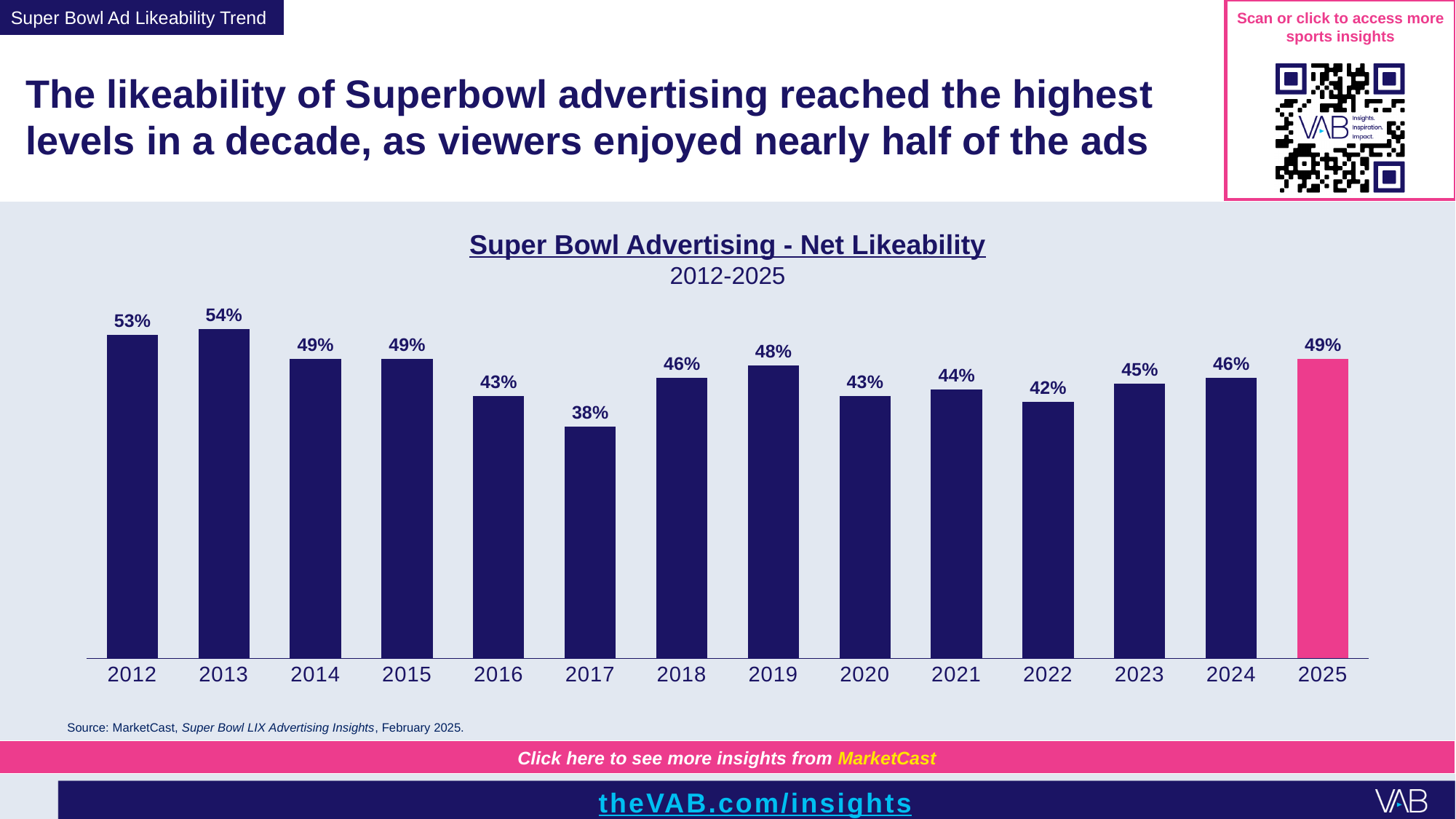
Which year's bar is coloured pink instead of dark navy? 2025 What is the difference between the net likeability in 2025 and in 2024? 3% What is the net likeability value for 2017? 38% Which year has a higher net likeability, 2018 or 2022? 2018 What is the difference between the net likeability in 2013 and in 2017? 16% Which year has the highest net likeability? 2013 Do the values rise or fall from 2020 to 2025? Rise What is the net likeability value for 2019? 48% How many years are shown on the x axis of the chart? 14 Which year has the lowest net likeability? 2017 What is the net likeability value for 2025? 49% What kind of chart is shown on the slide? Bar chart